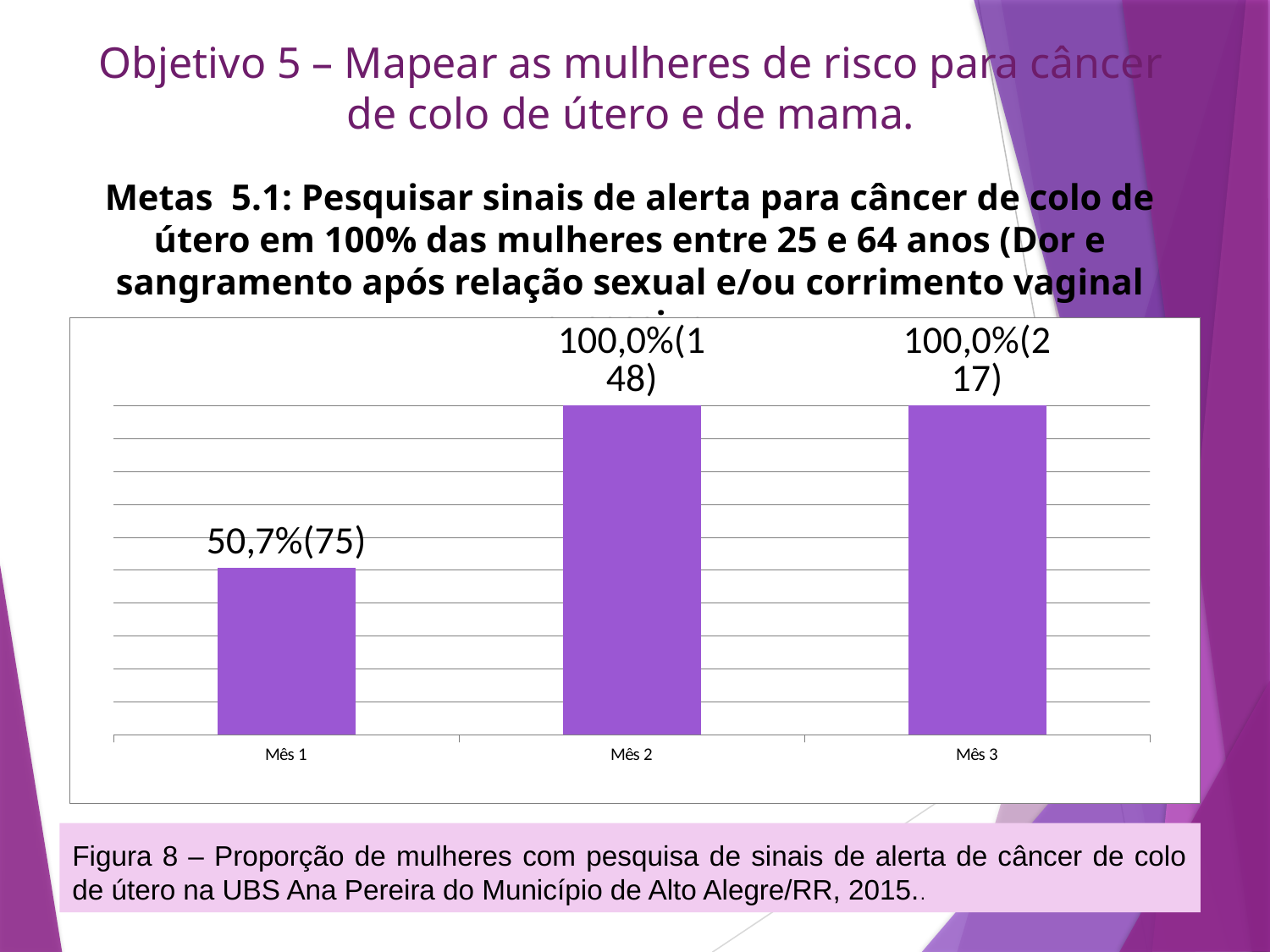
Which is larger, the value for Mês 1 or the value for Mês 2? Mês 2 What is the data label shown for Mês 2? 100,0%(148) How many categories are shown on the x axis? 3 What percentage is shown for Mês 1? 50,7% Do the values rise or fall from Mês 1 to Mês 3? Rise What is the data label shown for Mês 3? 100,0%(217) How many women are shown in parentheses for Mês 3? 217 How many more women are counted in Mês 2 than in Mês 1? 73 What is the difference in percentage points between Mês 2 and Mês 1? 49,3 What kind of chart is shown? Bar chart What is the data label shown for Mês 1? 50,7%(75) Which month has the lowest value? Mês 1